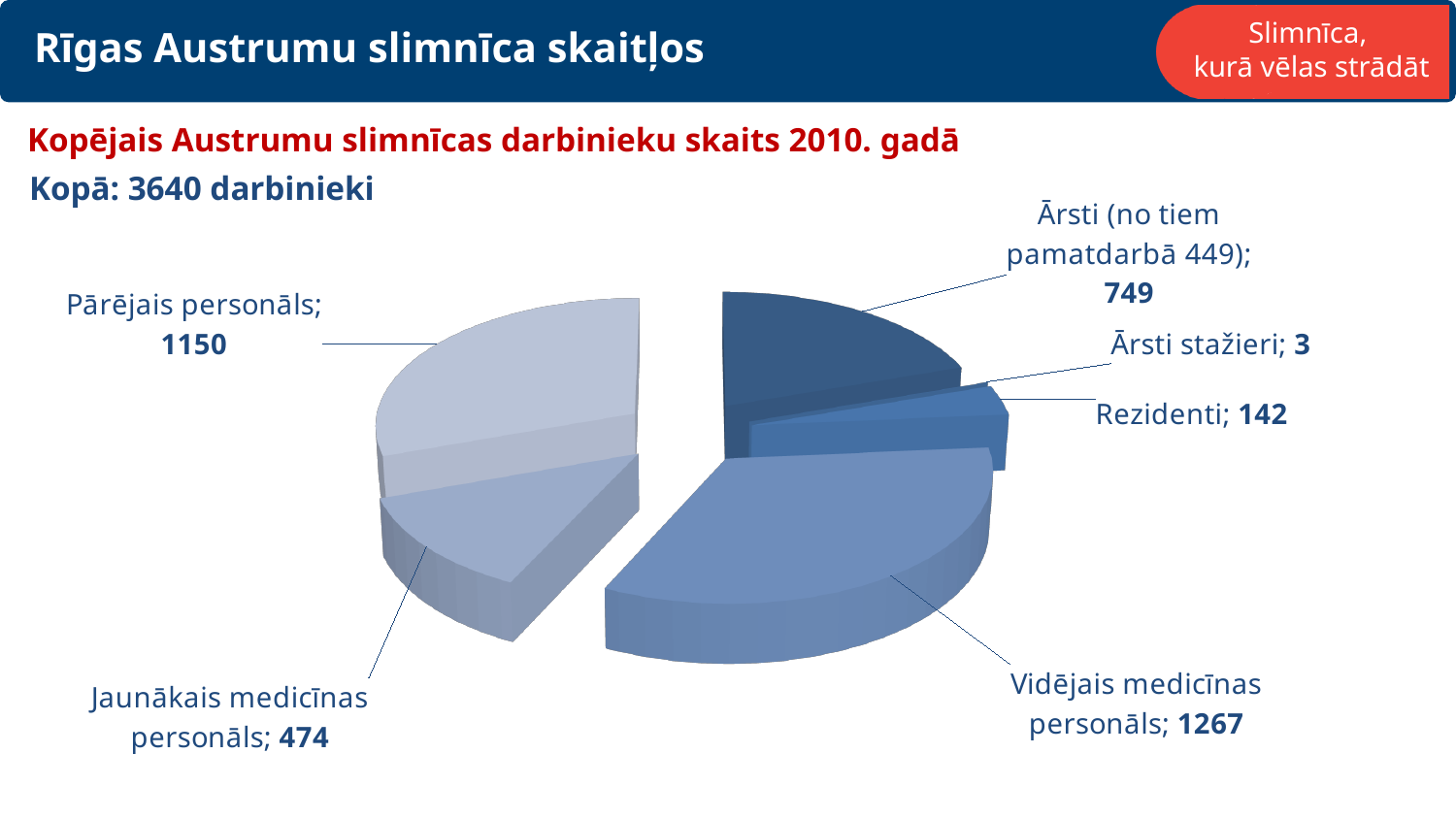
What is the value for Rezidenti? 142 What is the value for Vidējais medicīnas personāls? 1267 How many slices does the pie chart have? 6 Which category has the largest slice? Vidējais medicīnas personāls What kind of chart is shown on the slide? pie chart Which category has the smallest slice? Ārsti stažieri What is the difference between Ārsti and Jaunākais medicīnas personāls? 275 What is the value for Pārējais personāls? 1150 Which is larger, Ārsti or Rezidenti? Ārsti What is the value for Jaunākais medicīnas personāls? 474 What is the difference between Vidējais medicīnas personāls and Pārējais personāls? 117 What total number of employees (Kopā) is stated on the slide? 3640 darbinieki